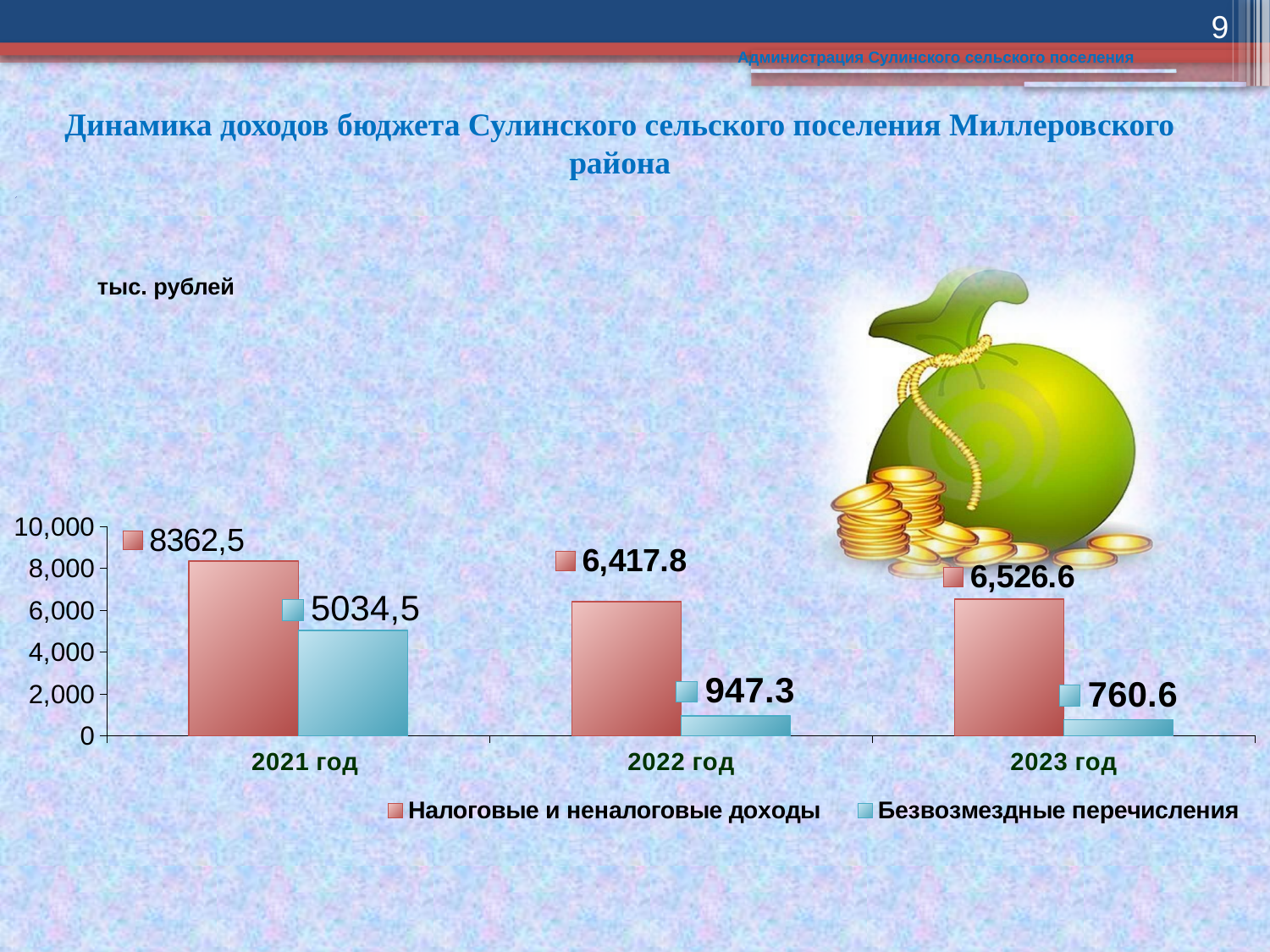
In which year is Безвозмездные перечисления the lowest? 2023 год Which is larger: Налоговые и неналоговые доходы in 2022 год or in 2023 год? 2023 год Do the values for Безвозмездные перечисления rise or fall from 2021 год to 2023 год? fall What kind of chart is shown on the slide? bar chart What is the value for Налоговые и неналоговые доходы in 2023 год? 6,526.6 What is the value for Налоговые и неналоговые доходы in 2021 год? 8362,5 What is the value for Безвозмездные перечисления in 2022 год? 947.3 How many years are shown on the x axis? 3 In which year is Налоговые и неналоговые доходы the highest? 2021 год How many series does the legend list? 2 What is the difference between Налоговые и неналоговые доходы and Безвозмездные перечисления in 2023 год? 5,766.0 What is the value for Безвозмездные перечисления in 2023 год? 760.6